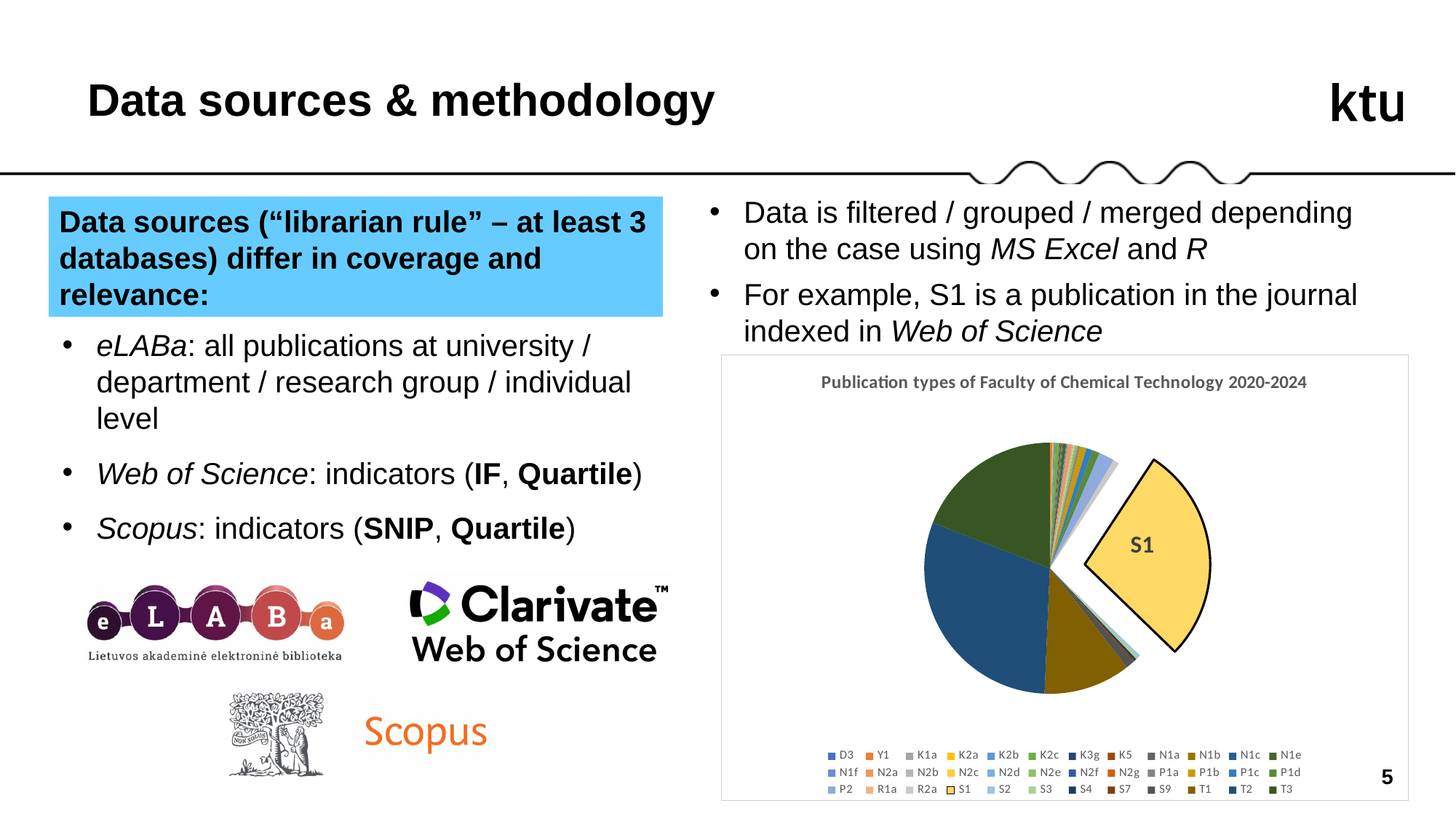
What is the title of the pie chart? Publication types of Faculty of Chemical Technology 2020-2024 What is the last entry in the pie chart's legend? T3 What kind of chart is shown on the slide? pie chart What is the first entry in the pie chart's legend? D3 Which slice of the pie chart is pulled out and labelled? S1 How many publication types are listed in the legend of the pie chart? 36